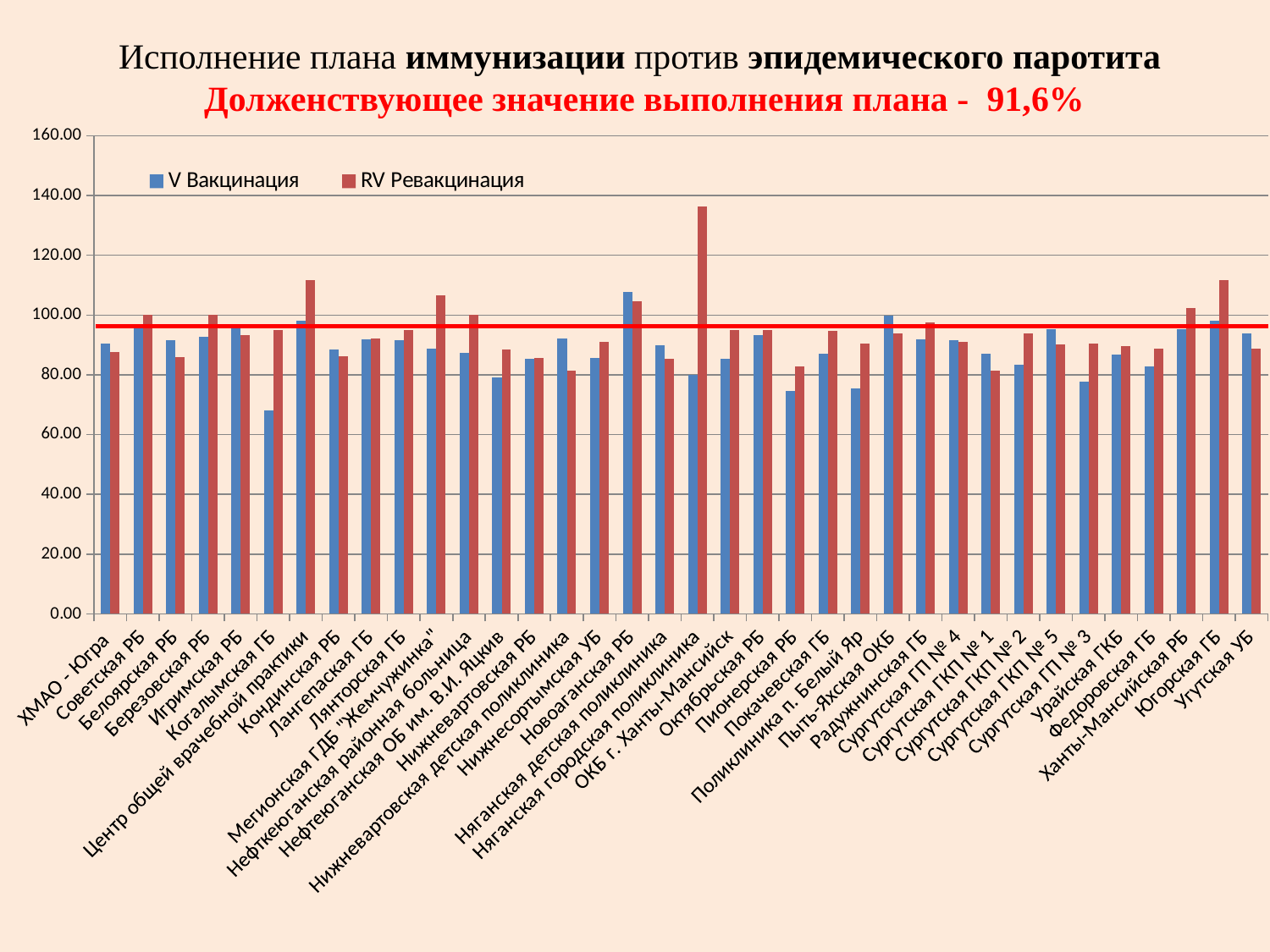
Which category has the lowest V Вакцинация value? Когалымская ГБ Is the RV Ревакцинация value for Югорская ГБ greater or less than 100? greater What are the two series named in the legend? V Вакцинация and RV Ревакцинация For Когалымская ГБ, which is larger: V Вакцинация or RV Ревакцинация? RV Ревакцинация Is the V Вакцинация value for Когалымская ГБ greater or less than 80? less For Мегионская ГДБ "Жемчужинка", which is larger: V Вакцинация or RV Ревакцинация? RV Ревакцинация What kind of chart is shown on the slide? bar chart What target value for plan fulfilment is stated in the red subtitle? 91,6% Which category has the highest V Вакцинация value? Новоаганская РБ Is the RV Ревакцинация value for Няганская городская поликлиника greater or less than 120? greater Which category has the highest RV Ревакцинация value? Няганская городская поликлиника How many series does the legend list? 2